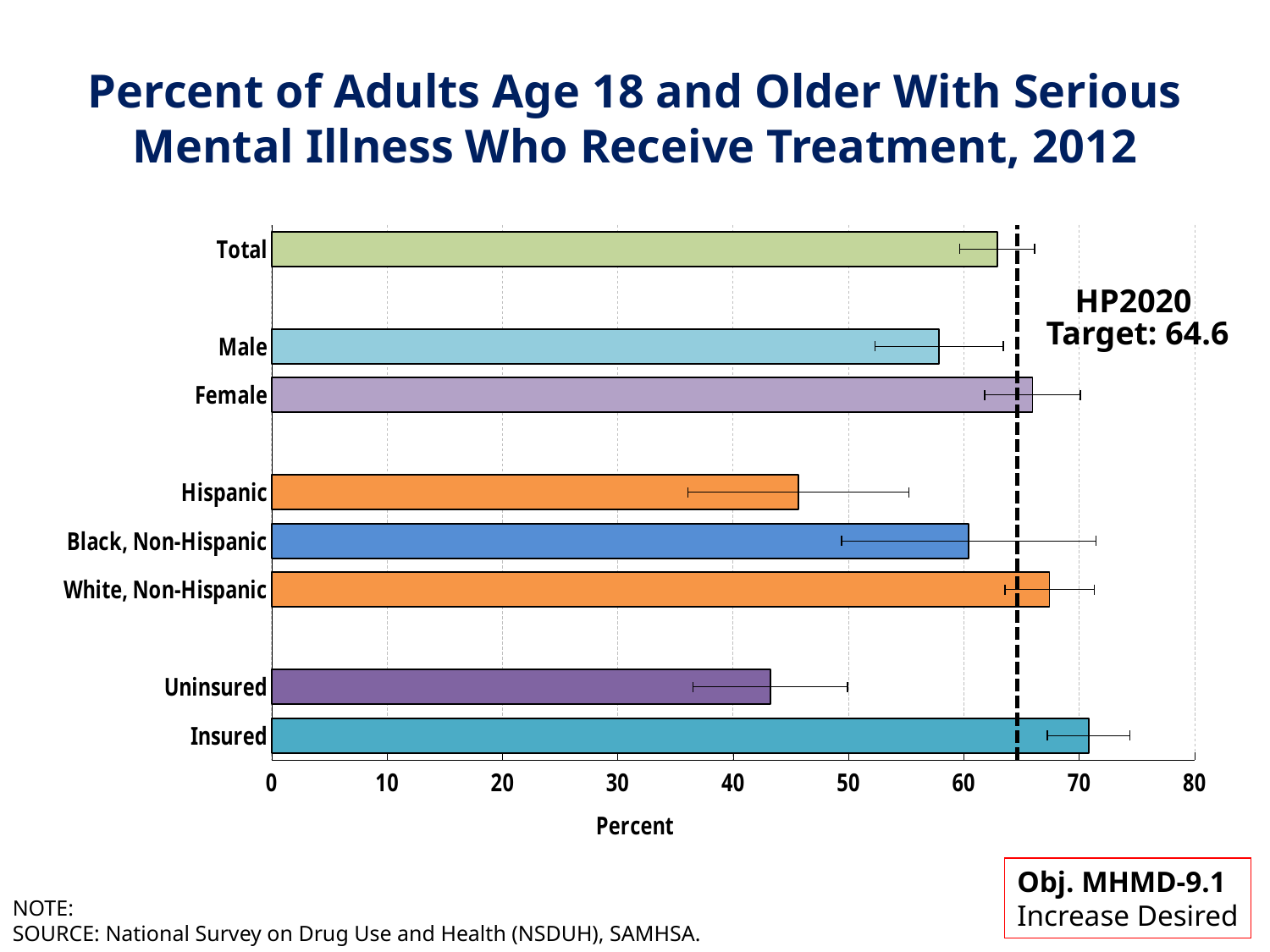
Is the value for Uninsured greater or less than 50? less How many bars (categories) are plotted in the chart? 8 Which category has the lowest percent receiving treatment? Uninsured What is the label of the horizontal axis? Percent Which is larger, the value for White, Non-Hispanic or the value for Hispanic? White, Non-Hispanic Is the value for Hispanic greater or less than 50? less Which is larger, the value for Female or the value for Male? Female What kind of chart is shown on the slide? bar chart Which category has the highest percent receiving treatment? Insured What is the HP2020 target value shown on the chart? 64.6 Is the value for Male greater or less than 60? less